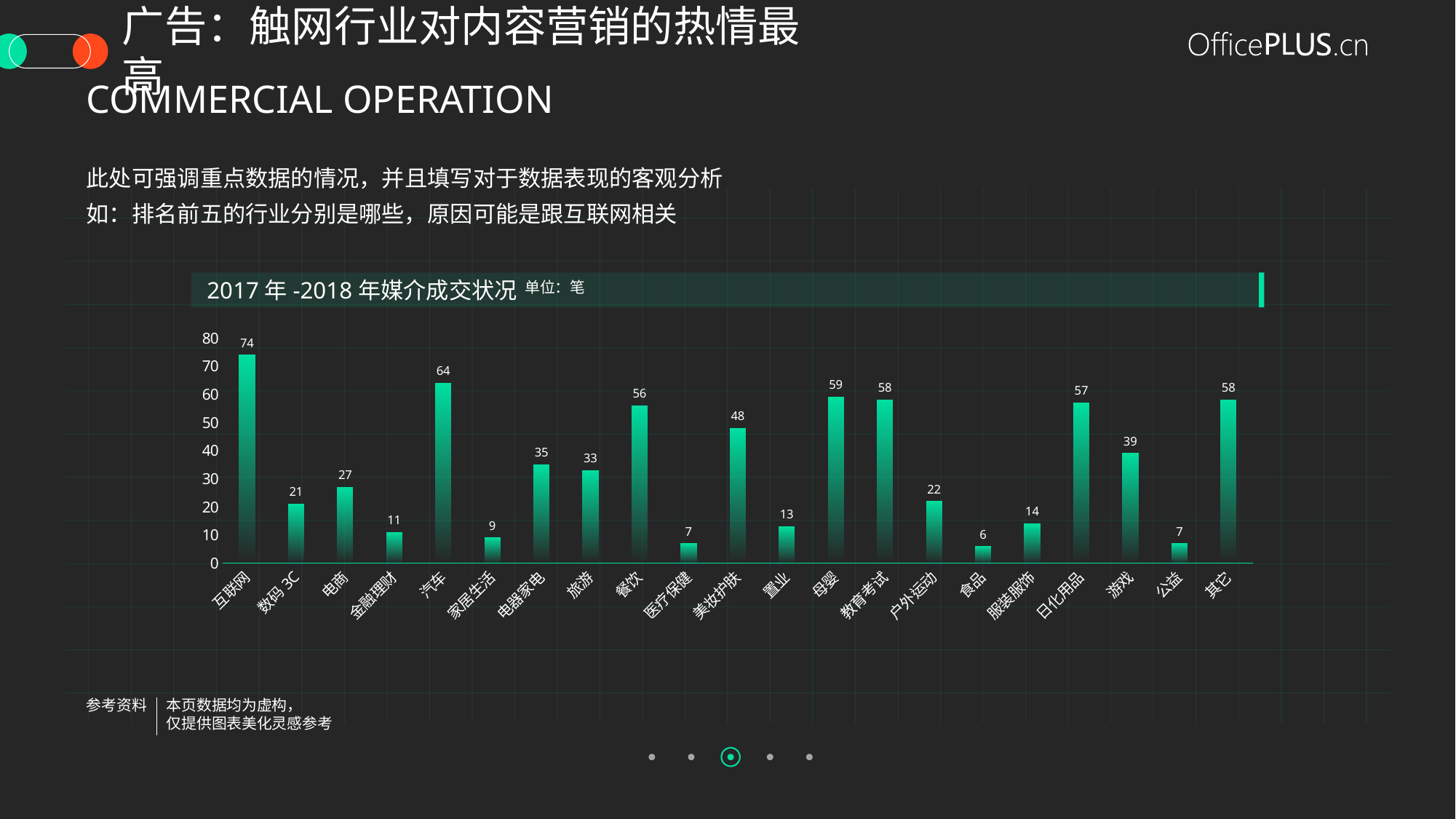
What kind of chart is this? bar chart Which is larger, the value for 数码3C or the value for 电商? 电商 What is the difference between the values for 互联网 and 汽车? 10 What is the value for 美妆护肤? 48 What is the title of the chart? 2017年-2018年媒介成交状况 Which is larger, the value for 餐饮 or the value for 电器家电? 餐饮 Which category has the lowest value? 食品 How many categories are shown on the x axis? 21 Which category has the highest value? 互联网 What is the value for 互联网? 74 What is the difference between the values for 母婴 and 户外运动? 37 What is the value for 游戏? 39